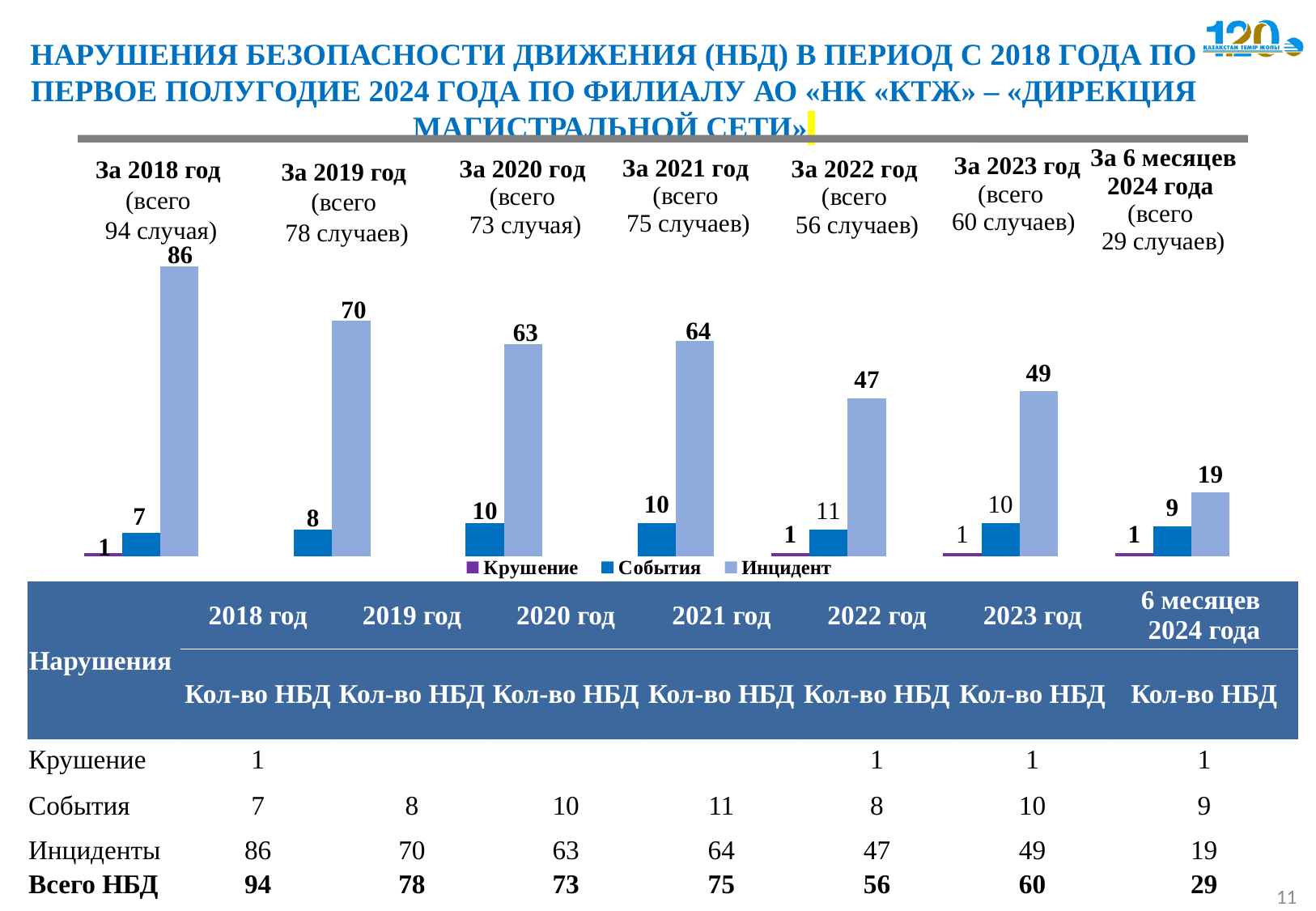
What is the value of the Инцидент bar for the first 6 months of 2024? 19 How many series does the legend list? 3 How many year periods are shown on the chart? 7 Which year has the highest Инцидент value? За 2018 год Which period has the lowest Инцидент value? За 6 месяцев 2024 года What is the value of the События bar for 2019 (За 2019 год)? 8 Which is larger, the Инцидент value for 2022 or for 2023? 2023 What is the value of the Крушение bar for 2023 (За 2023 год)? 1 What kind of chart is shown on the slide? Bar chart Which series is shown in light blue in the legend? Инцидент What is the value of the Инцидент bar for 2018 (За 2018 год)? 86 What is the difference between the Инцидент values for 2018 and 2019? 16